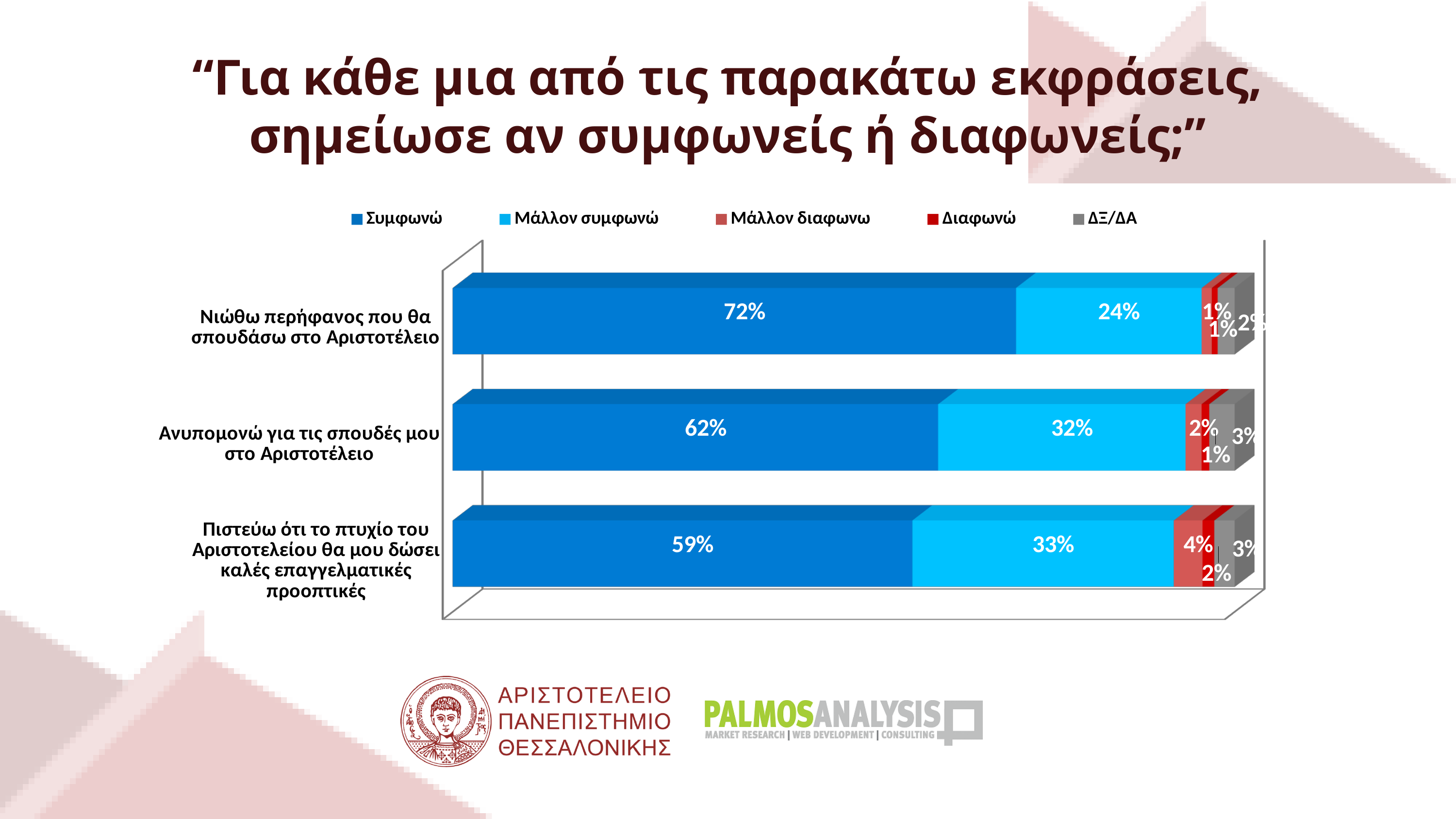
Which statement has the lowest Συμφωνώ value? Πιστεύω ότι το πτυχίο του Αριστοτελείου θα μου δώσει καλές επαγγελματικές προοπτικές What is the Μάλλον συμφωνώ value for the statement "Ανυπομονώ για τις σπουδές μου στο Αριστοτέλειο"? 32% Which statement has the larger Μάλλον συμφωνώ value: "Νιώθω περήφανος που θα σπουδάσω στο Αριστοτέλειο" or "Πιστεύω ότι το πτυχίο του Αριστοτελείου θα μου δώσει καλές επαγγελματικές προοπτικές"? Πιστεύω ότι το πτυχίο του Αριστοτελείου θα μου δώσει καλές επαγγελματικές προοπτικές Which statement has the highest Συμφωνώ value? Νιώθω περήφανος που θα σπουδάσω στο Αριστοτέλειο What is the Συμφωνώ value for the statement "Νιώθω περήφανος που θα σπουδάσω στο Αριστοτέλειο"? 72% What colour represents the Συμφωνώ series in the legend? Dark blue What is the ΔΞ/ΔΑ value for the statement "Νιώθω περήφανος που θα σπουδάσω στο Αριστοτέλειο"? 2% How many series does the legend list? 5 What is the difference between the Συμφωνώ values for "Νιώθω περήφανος που θα σπουδάσω στο Αριστοτέλειο" and "Πιστεύω ότι το πτυχίο του Αριστοτελείου θα μου δώσει καλές επαγγελματικές προοπτικές"? 13 percentage points What kind of chart is shown on the slide? Stacked bar chart How many statements (categories) are plotted in the chart? 3 What is the Συμφωνώ value for the statement "Πιστεύω ότι το πτυχίο του Αριστοτελείου θα μου δώσει καλές επαγγελματικές προοπτικές"? 59%